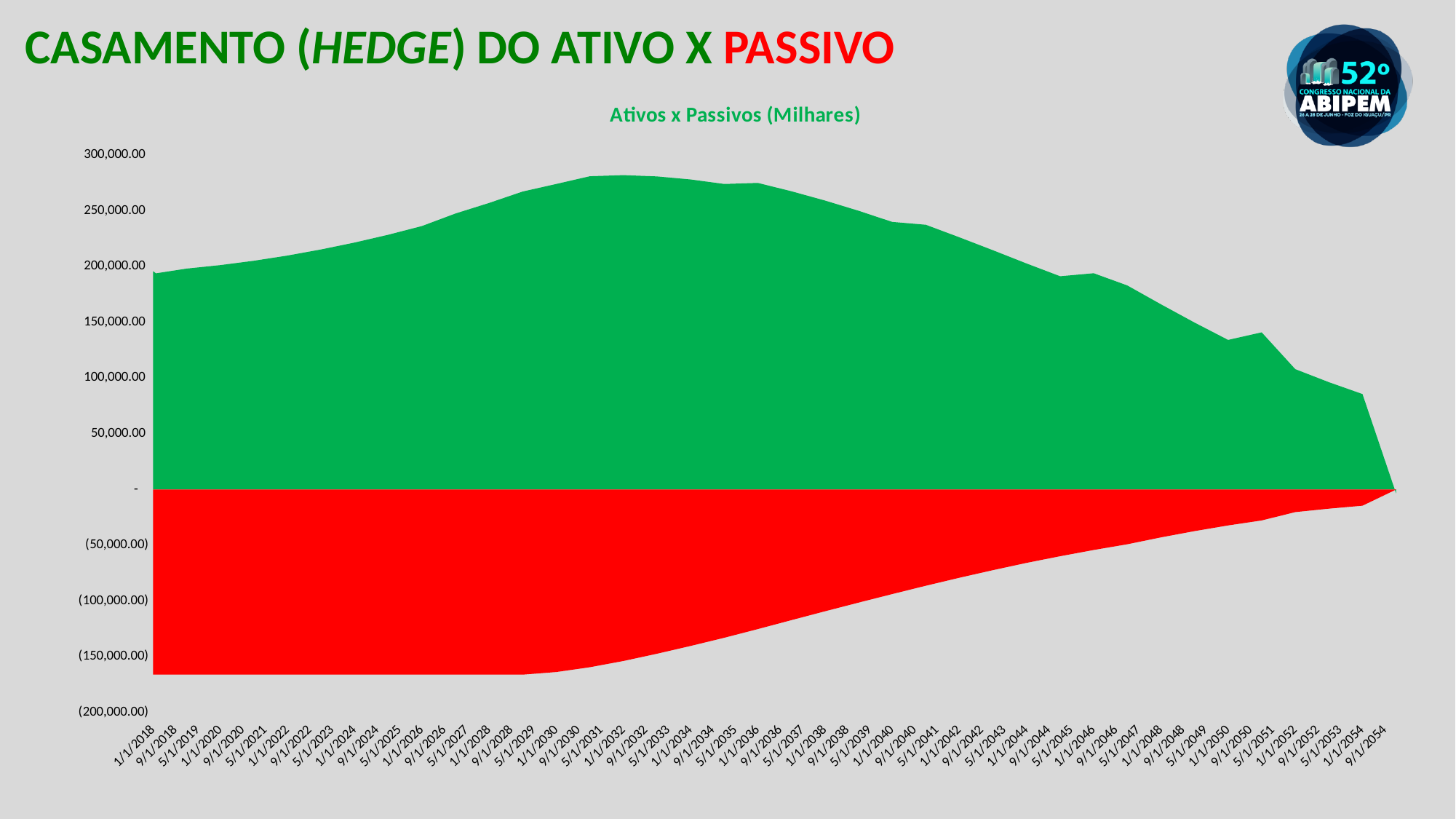
Is the value of the green area at 9/1/2031 greater or less than 250,000.00? greater Is the value of the green area at 1/1/2018 greater or less than 150,000.00? greater Is the value of the red area at 1/1/2018 greater or less than (150,000.00)? less Which colour is used for the area plotted above zero? green Does the green area rise or fall between 9/1/2031 and 9/1/2054? fall Does the green area rise or fall between 1/1/2018 and 9/1/2031? rise What is the title of the chart? Ativos x Passivos (Milhares) What kind of chart is shown on the slide? area chart Does the red area move toward zero or away from zero along the x axis from 1/1/2030 to 9/1/2054? toward zero